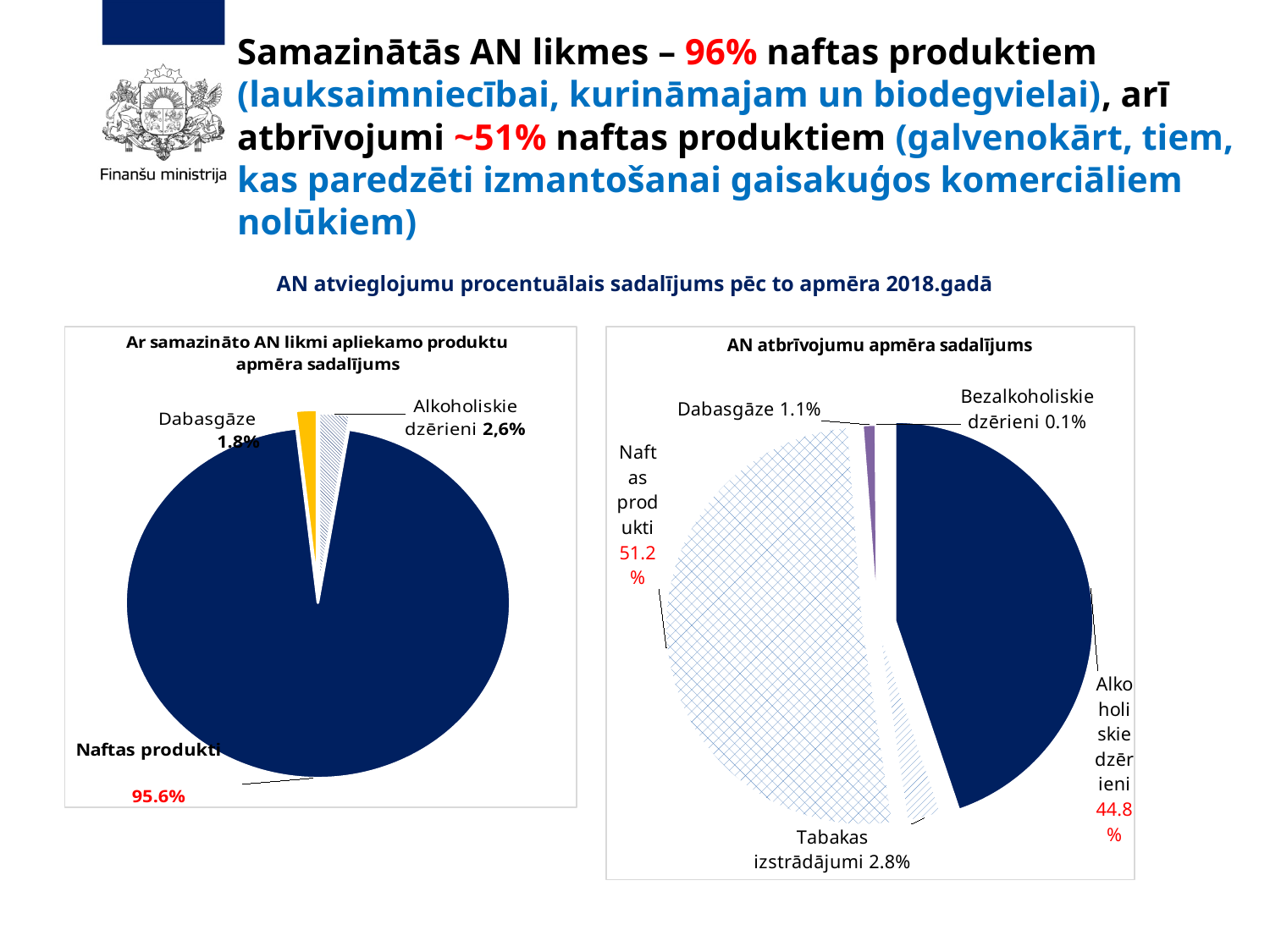
In the left chart, 'Ar samazināto AN likmi apliekamo produktu apmēra sadalījums', what share is shown for Naftas produkti? 95.6% In the left chart, 'Ar samazināto AN likmi apliekamo produktu apmēra sadalījums', which category has the largest slice? Naftas produkti In the left chart, 'Ar samazināto AN likmi apliekamo produktu apmēra sadalījums', what share is shown for Alkoholiskie dzērieni? 2,6% In the right chart, 'AN atbrīvojumu apmēra sadalījums', which category has the smallest slice? Bezalkoholiskie dzērieni In the right chart, 'AN atbrīvojumu apmēra sadalījums', what share is shown for Naftas produkti? 51.2% In the right chart, 'AN atbrīvojumu apmēra sadalījums', what share is shown for Alkoholiskie dzērieni? 44.8% In the right chart, 'AN atbrīvojumu apmēra sadalījums', what is the difference between the shares of Naftas produkti and Alkoholiskie dzērieni? 6.4% How many slices does the left chart, 'Ar samazināto AN likmi apliekamo produktu apmēra sadalījums', have? 3 In the right chart, 'AN atbrīvojumu apmēra sadalījums', what share is shown for Tabakas izstrādājumi? 2.8% What kind of chart is the left chart, 'Ar samazināto AN likmi apliekamo produktu apmēra sadalījums'? Pie chart In the left chart, 'Ar samazināto AN likmi apliekamo produktu apmēra sadalījums', what share is shown for Dabasgāze? 1,8% How many slices does the right chart, 'AN atbrīvojumu apmēra sadalījums', have? 5